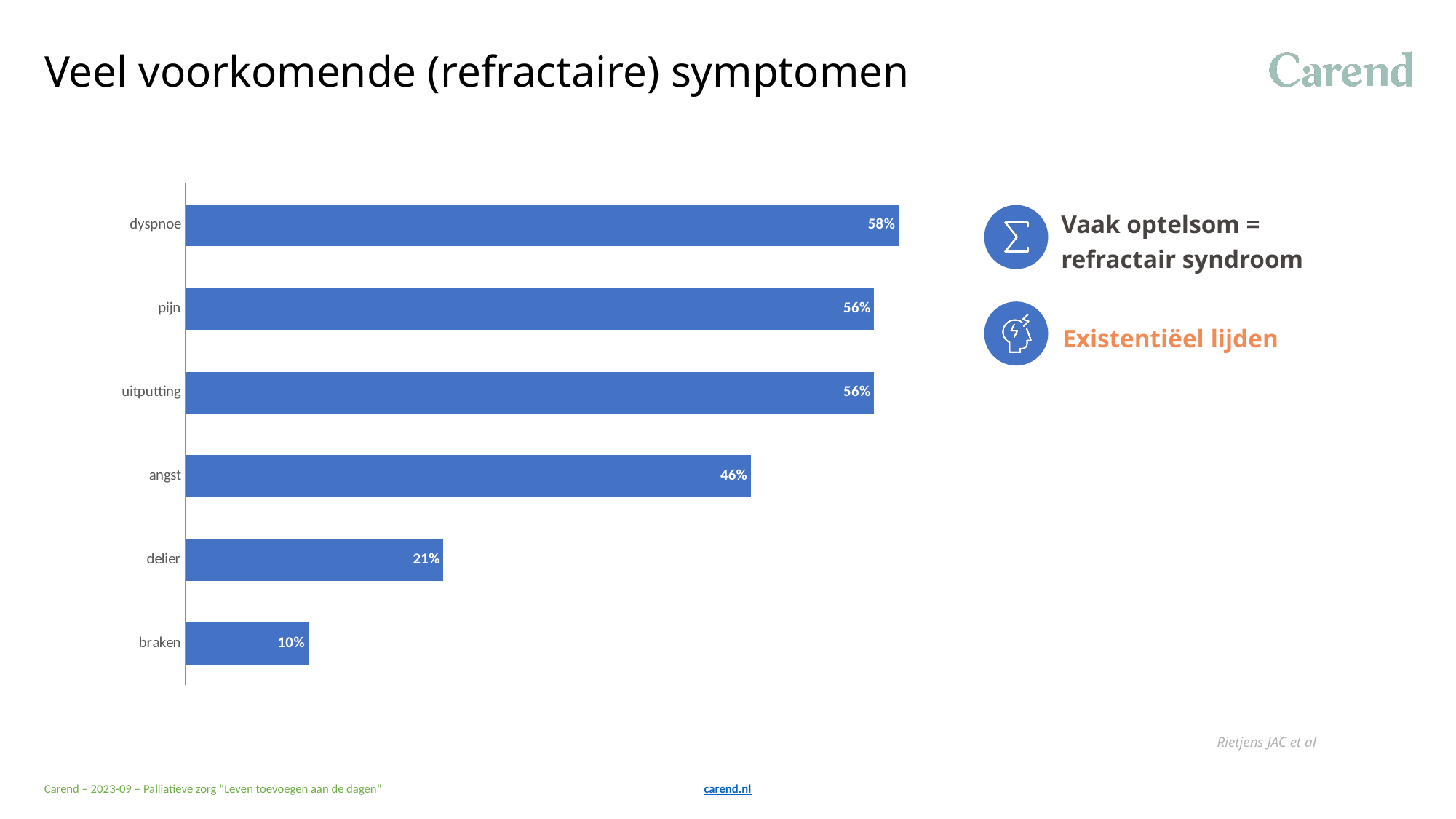
What is the value for angst? 46% What is the value for delier? 21% What is the difference between the values for dyspnoe and braken? 48% What kind of chart is shown on the slide? bar chart What is the value for braken? 10% Which is larger, the value for angst or the value for delier? angst What is the difference between the values for angst and delier? 25% What is the value for dyspnoe? 58% How many categories are shown in the chart? 6 Which category has the highest value? dyspnoe Which two categories share the same value of 56%? pijn and uitputting Which category has the lowest value? braken